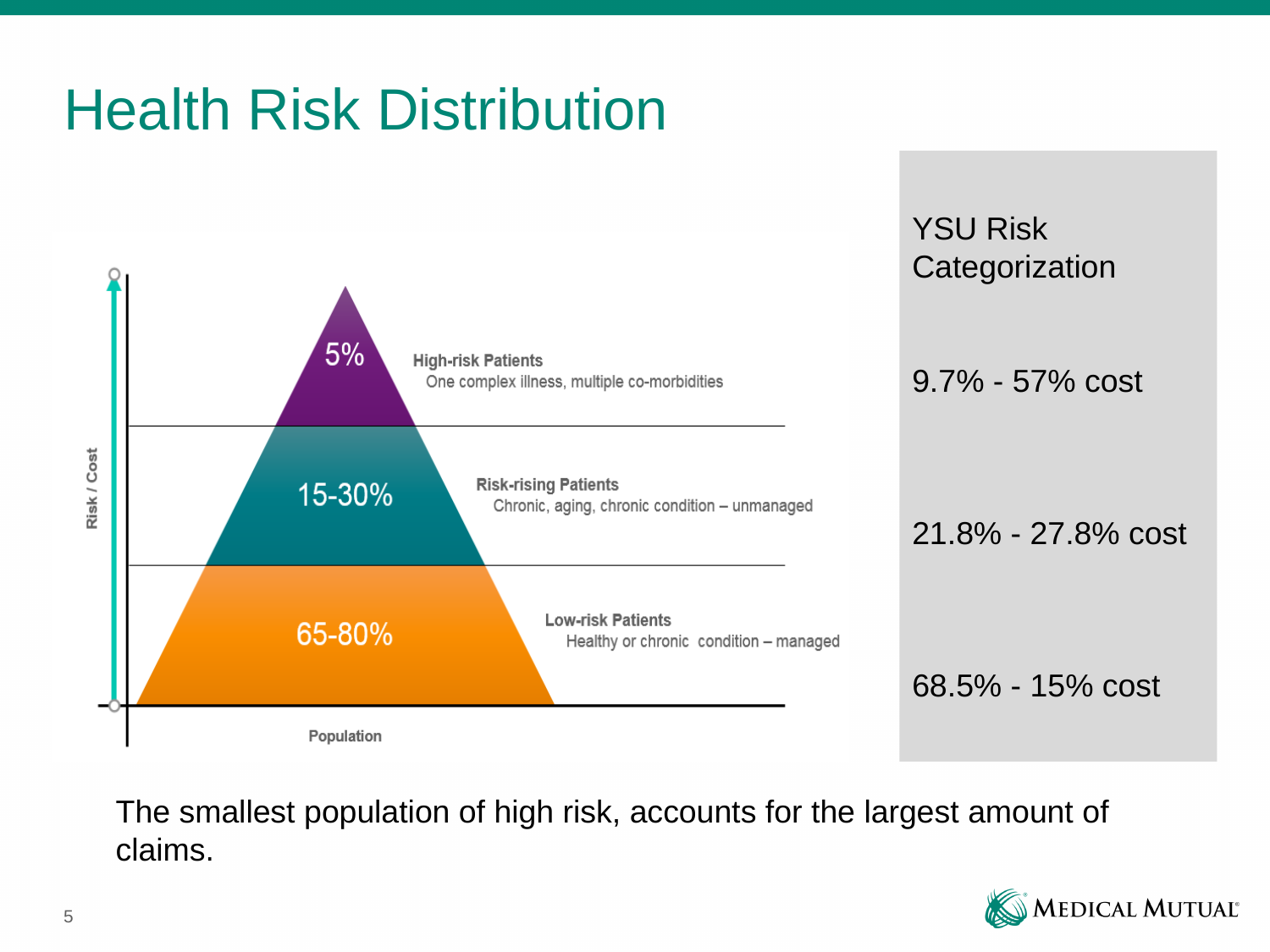
What kind of chart is shown on the slide? Pyramid chart Which patient group has the smallest share of the population in the pyramid? High-risk Patients Which group has a larger population share, High-risk Patients or Risk-rising Patients? Risk-rising Patients Which patient group is described as 'Healthy or chronic condition – managed'? Low-risk Patients Which patient group has the largest share of the population in the pyramid? Low-risk Patients What is the label on the vertical axis of the pyramid chart? Risk / Cost What percentage range is shown for Low-risk Patients in the pyramid? 65-80% What is the label on the horizontal axis of the pyramid chart? Population What percentage range is shown for Risk-rising Patients in the pyramid? 15-30% What percentage is shown for High-risk Patients in the pyramid? 5% Which patient group is described as 'One complex illness, multiple co-morbidities'? High-risk Patients How many tiers does the pyramid have? 3